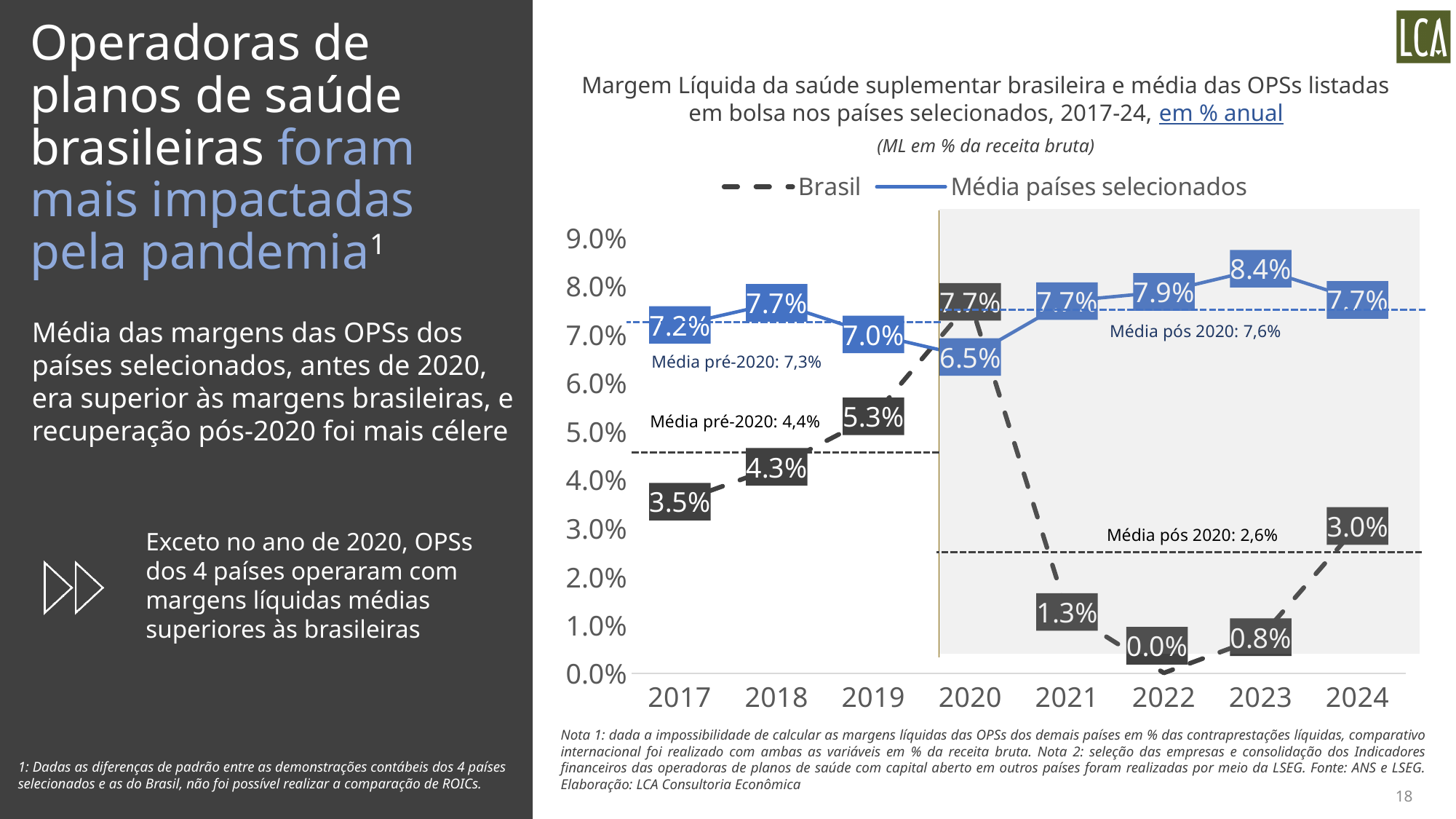
What is the value for Brasil in 2022? 0.0% In which year does the Brasil series reach its lowest value? 2022 What is the 'Média pós 2020' value annotated for Brasil? 2,6% How many years are shown on the x axis? 8 What is the value for Média países selecionados in 2023? 8.4% How many series does the legend list? 2 In which year does the Média países selecionados series reach its highest value? 2023 Does the Brasil series rise or fall from 2017 to 2019? Rise What is the value for Brasil in 2020? 7.7% What is the difference between Média países selecionados and Brasil in 2024? 4.7% What kind of chart is shown on the slide? Line chart Which series has the larger value in 2019, Brasil or Média países selecionados? Média países selecionados